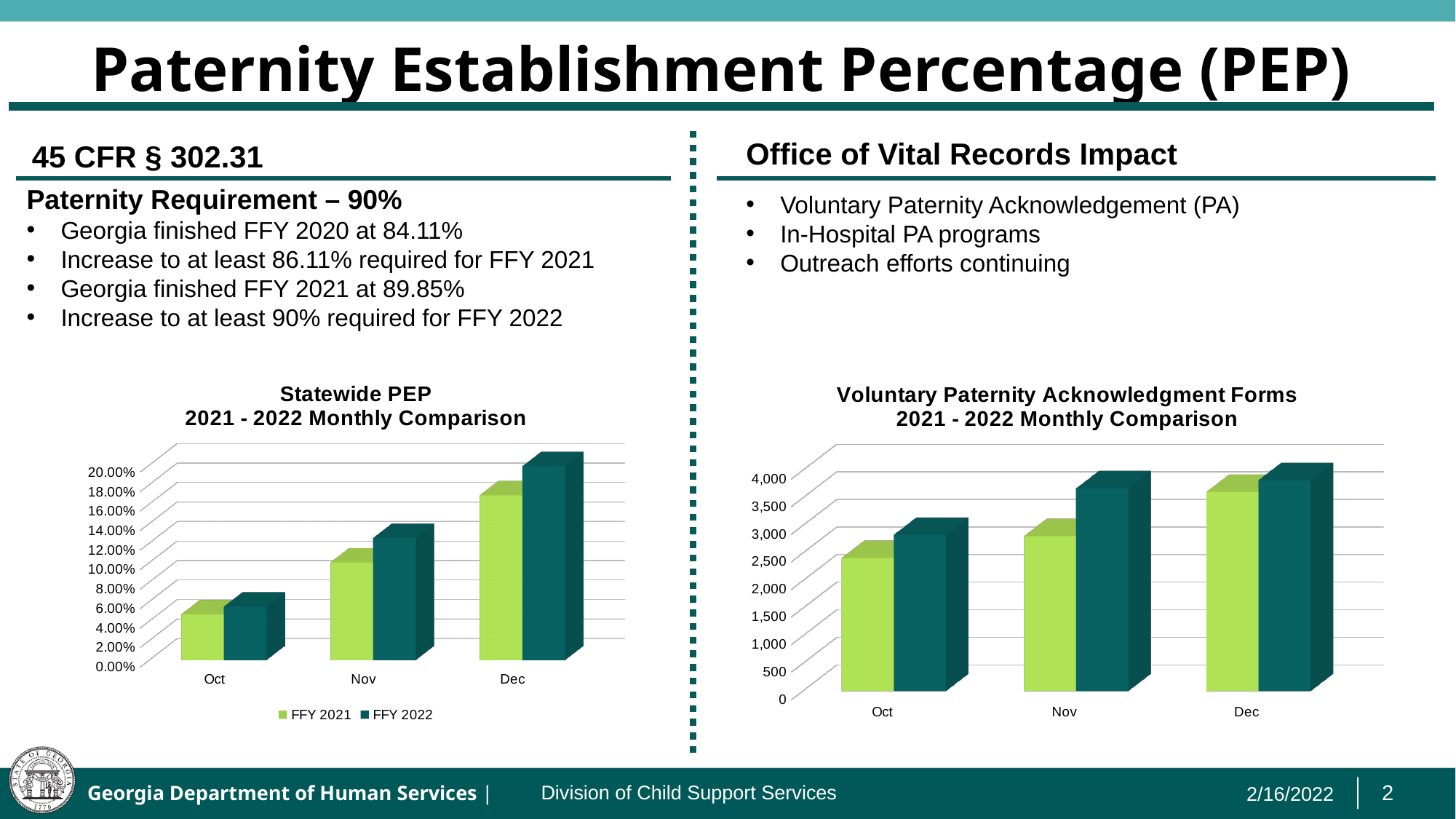
What kind of chart is the Statewide PEP 2021 - 2022 Monthly Comparison chart? Bar chart In the Voluntary Paternity Acknowledgment Forms chart, which is larger for Oct: the FFY 2021 value or the FFY 2022 value? FFY 2022 In the Voluntary Paternity Acknowledgment Forms chart, is the FFY 2022 value for Nov greater or less than 3,000? greater In the Voluntary Paternity Acknowledgment Forms chart, which month has the highest FFY 2022 value? Dec In the Voluntary Paternity Acknowledgment Forms chart, is the FFY 2021 value for Oct greater or less than 2,000? greater How many months are shown on the x axis of the Voluntary Paternity Acknowledgment Forms chart? 3 In the Statewide PEP chart, do the FFY 2022 values rise or fall from Oct to Dec? Rise In the Statewide PEP chart, is the FFY 2021 value for Oct greater or less than 8.00%? less In the Statewide PEP chart, which month has the lowest FFY 2021 value? Oct In the Statewide PEP chart, which month has the highest FFY 2022 value? Dec How many series does the legend of the Statewide PEP chart list? 2